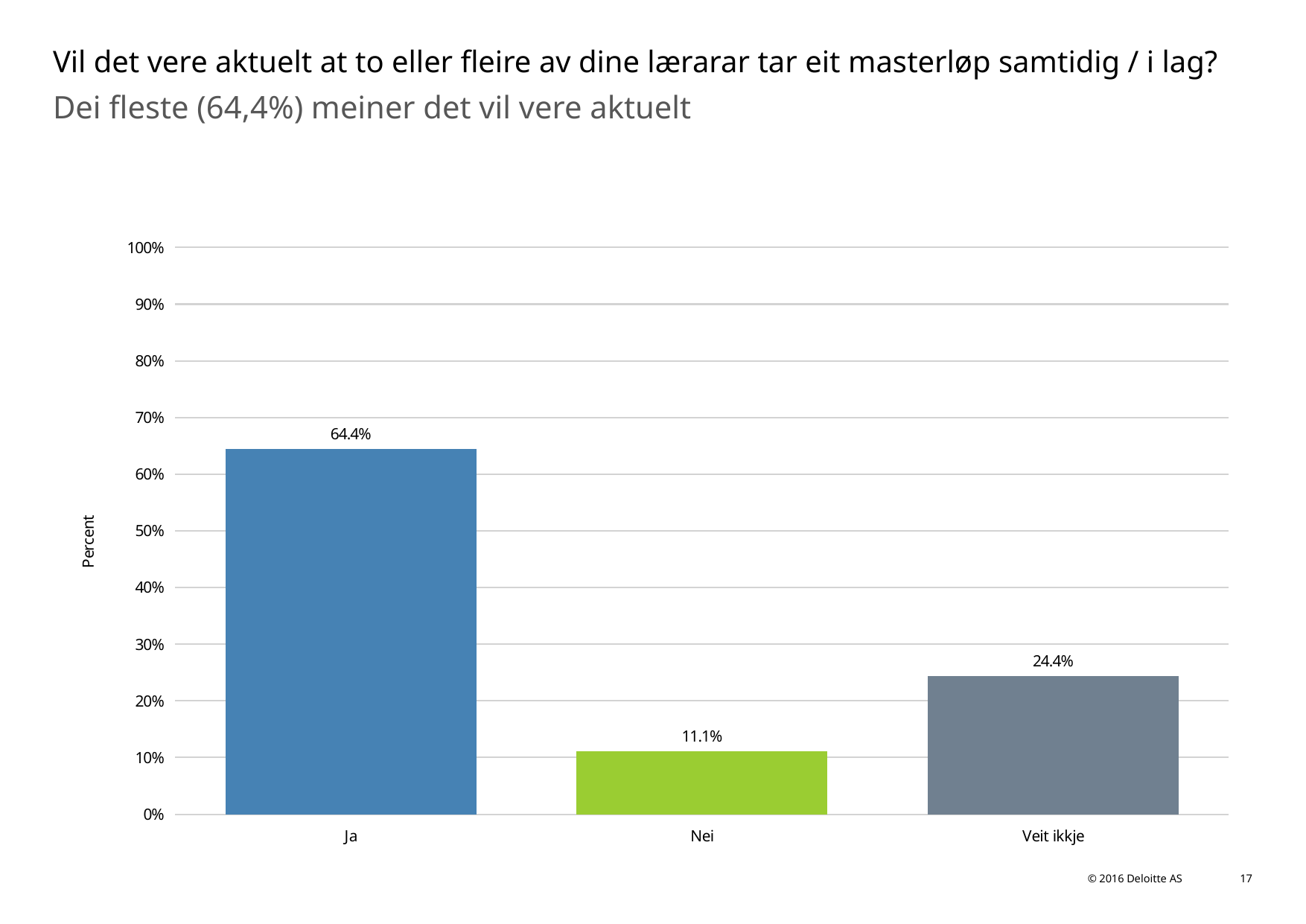
What is the difference between the values for Veit ikkje and Nei? 13.3% Which is larger, the value for Nei or the value for Veit ikkje? Veit ikkje What is the value for Veit ikkje? 24.4% Which category has the lowest value? Nei How many categories are shown on the x axis? 3 Which category has the highest value? Ja What is the difference between the values for Ja and Veit ikkje? 40.0% What is the label of the y axis? Percent What is the value for Nei? 11.1% What is the value for Ja? 64.4% What kind of chart is shown on the slide? bar chart Is the value for Ja greater or less than 60%? greater